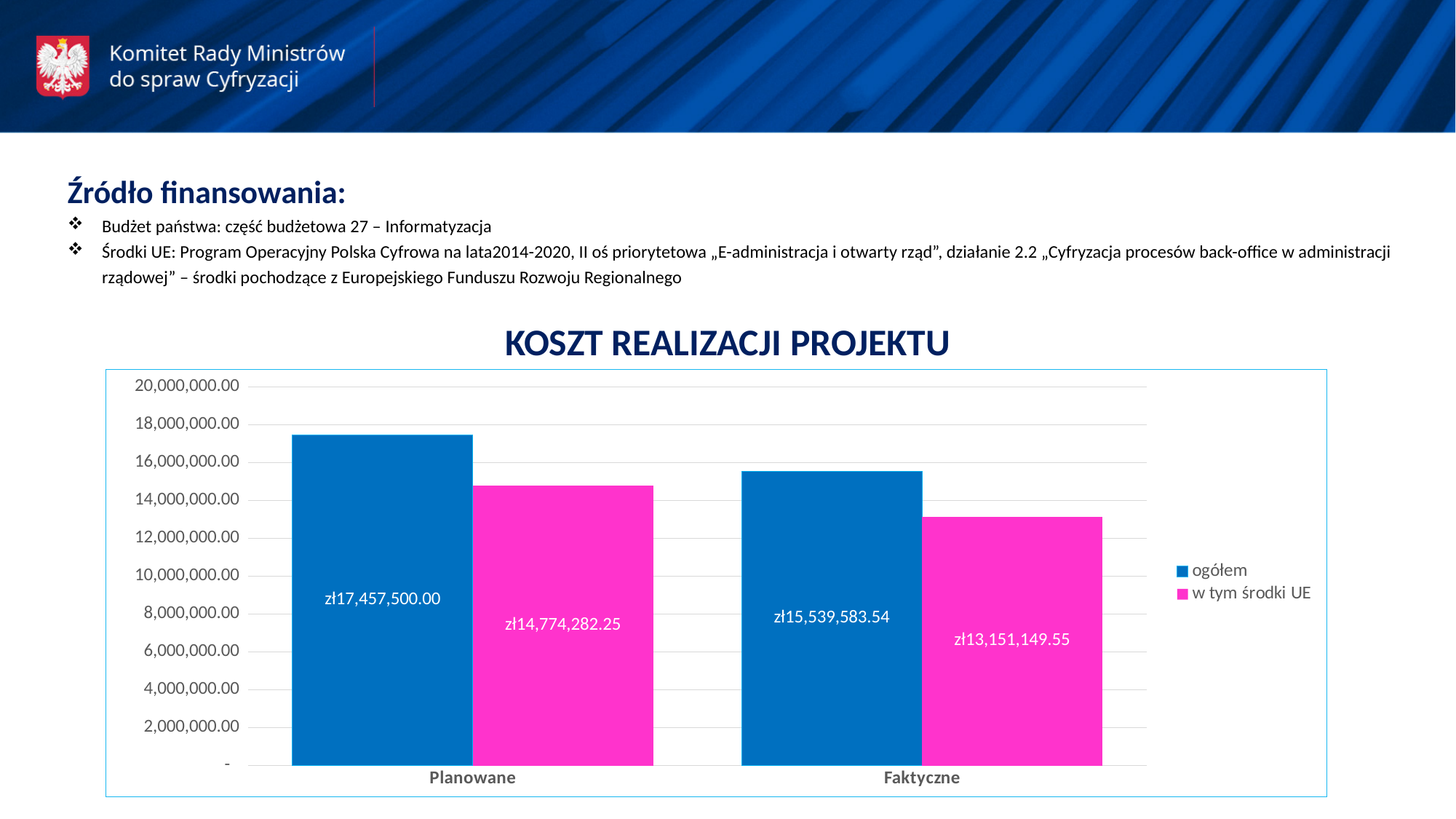
Which bar in the chart has the lowest value? w tym środki UE for Faktyczne What type of chart is shown on the slide? Bar chart Which bar in the chart has the highest value? ogółem for Planowane What is the value of 'ogółem' for Faktyczne? zł15,539,583.54 What is the value of 'ogółem' for Planowane? zł17,457,500.00 What is the difference between the 'ogółem' values for Planowane and Faktyczne? zł1,917,916.46 How many series does the legend list? 2 What is the difference between 'ogółem' and 'w tym środki UE' for Faktyczne? zł2,388,433.99 What is the value of 'w tym środki UE' for Planowane? zł14,774,282.25 How many categories are shown on the x axis? 2 Which is larger: 'w tym środki UE' for Planowane or 'ogółem' for Faktyczne? ogółem for Faktyczne What is the value of 'w tym środki UE' for Faktyczne? zł13,151,149.55